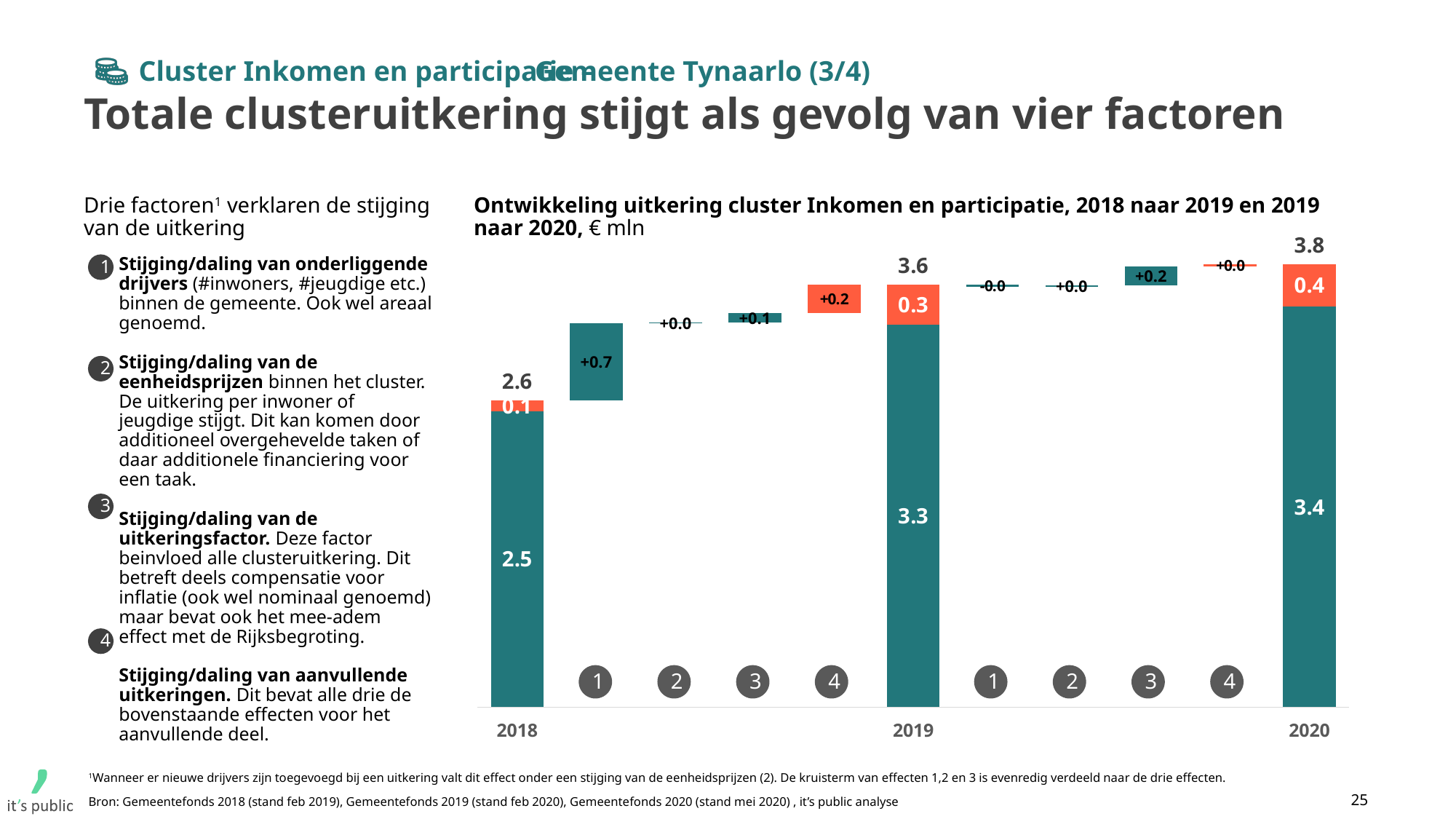
What is the value of the orange (upper) segment of the 2019 bar? 0.3 What is the total value shown for 2018? 2.6 What is the value of step 3 between 2019 and 2020? +0.2 What unit is stated in the chart title? € mln Which of the four steps between 2018 and 2019 has the largest value? 1 Do the year totals rise or fall from 2018 to 2020? rise Which is larger, the teal segment of the 2019 bar or the teal segment of the 2018 bar? 2019 What is the difference between the 2020 total and the 2018 total? 1.2 What is the total value shown for 2019? 3.6 What is the total value shown for 2020? 3.8 What is the value of the teal (lower) segment of the 2020 bar? 3.4 What is the value of step 1 between 2018 and 2019? +0.7